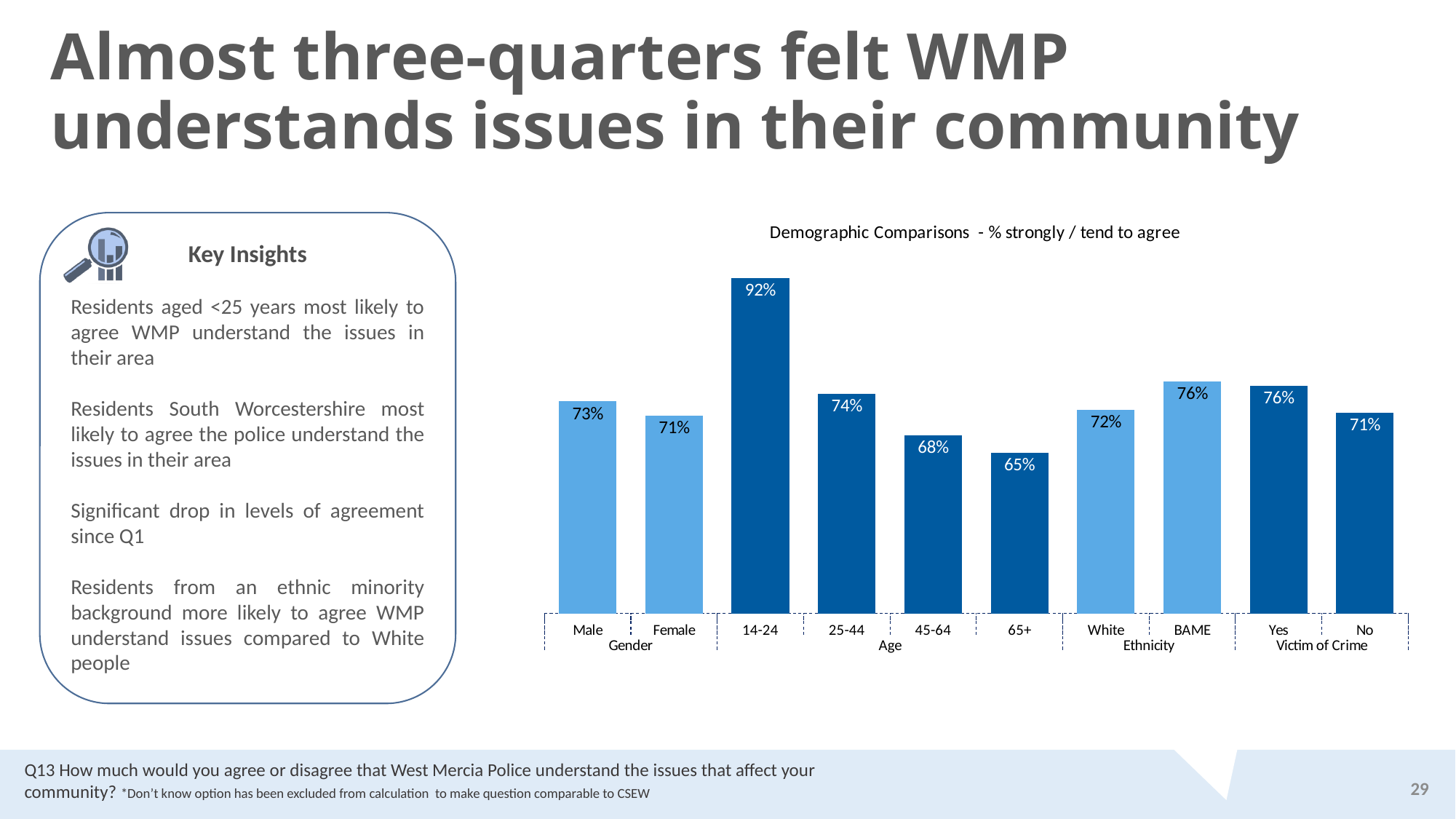
What is the title of the chart? Demographic Comparisons - % strongly / tend to agree What is the difference between the values for Male and Female? 2% What is the value for BAME? 76% Which category has the lowest value? 65+ Which is larger, the value for 25-44 or the value for 45-64? 25-44 What is the difference between the values for BAME and White? 4% What is the value for the 65+ age group? 65% What kind of chart is shown? Bar chart How many bars are plotted in the chart? 10 What is the value for the 14-24 age group? 92% Which category has the highest value? 14-24 What is the value for Female? 71%